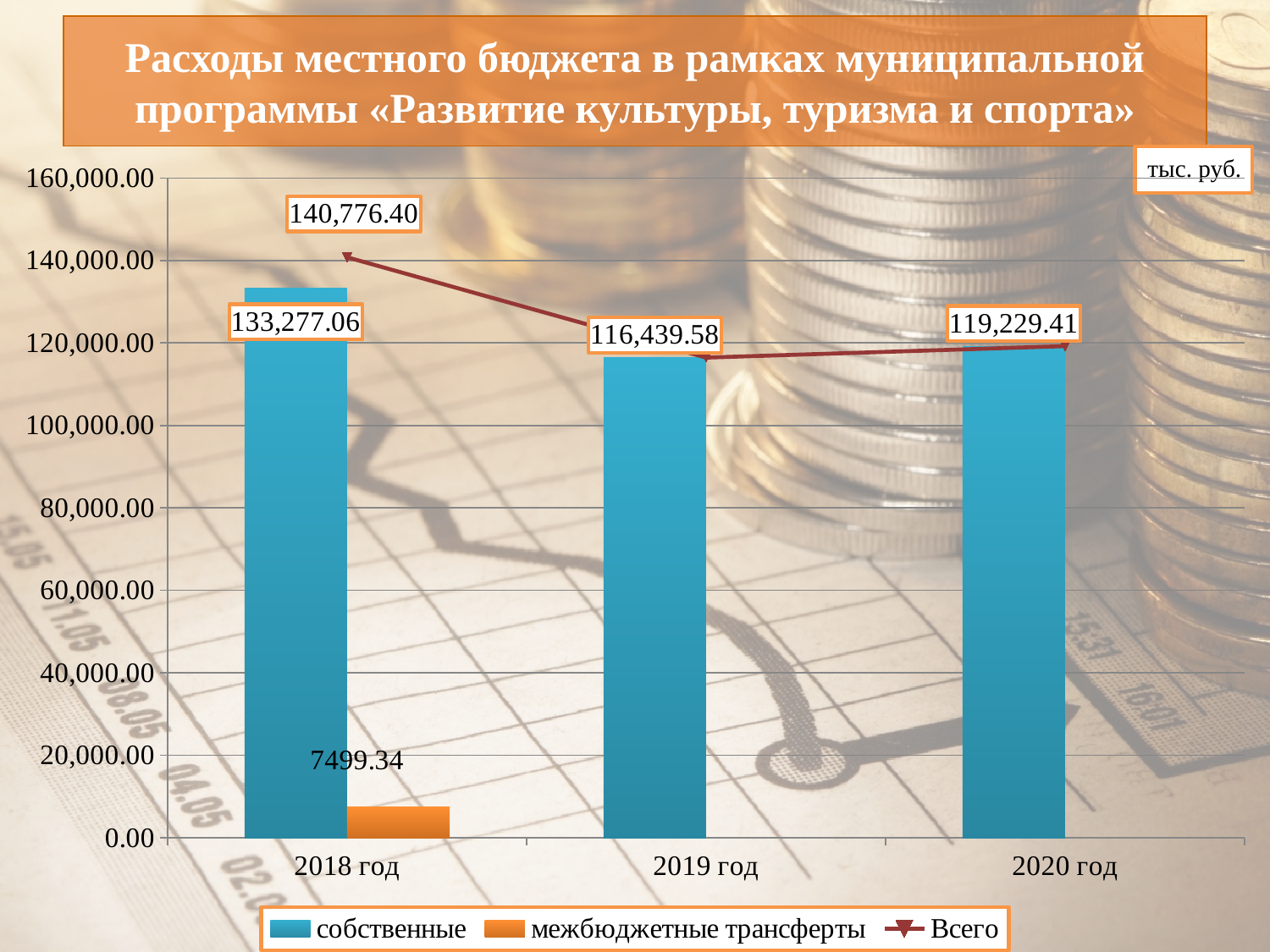
What is the value of the «Всего» line for 2018 год? 140,776.40 How many series does the legend list? 3 What is the value of the «межбюджетные трансферты» bar for 2018 год? 7499.34 Is the «собственные» bar for 2019 год greater or less than 120,000.00? less What is the value of the «Всего» line for 2019 год? 116,439.58 What is the value of the «Всего» line for 2020 год? 119,229.41 In which year is the «Всего» value the highest? 2018 год What is the value of the «собственные» bar for 2018 год? 133,277.06 Does the «Всего» line rise or fall from 2018 год to 2019 год? fall By how much does the «Всего» value for 2018 год exceed the «Всего» value for 2019 год? 24,336.82 In which year is the «Всего» value the lowest? 2019 год Which year has the larger «Всего» value, 2019 год or 2020 год? 2020 год